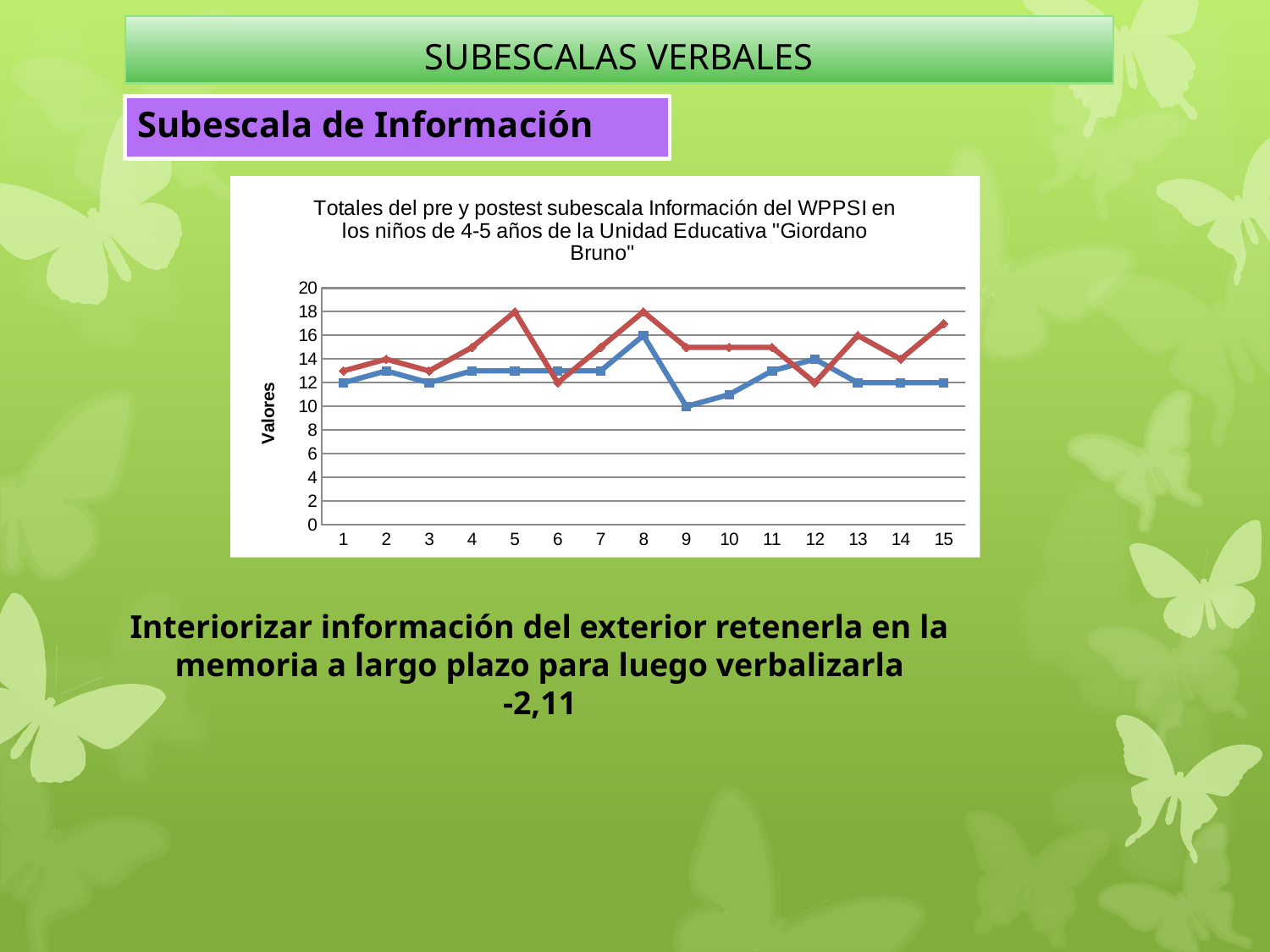
What is the value of the blue line at point 9? 10 What is the value of the red line at point 13? 16 At point 8, what is the difference between the red line and the blue line? 2 What is the label of the vertical axis of the chart? Valores What is the value of the red line at point 5? 18 At which x-axis point does the blue line reach its highest value? 8 At which x-axis point does the blue line reach its lowest value? 9 Is the value of the red line at point 7 greater or less than 14? greater At point 5, which line has the larger value, the red line or the blue line? red line What is the value of the blue line at point 8? 16 What kind of chart is shown on the slide? line chart How many points are plotted along the x axis of the chart? 15